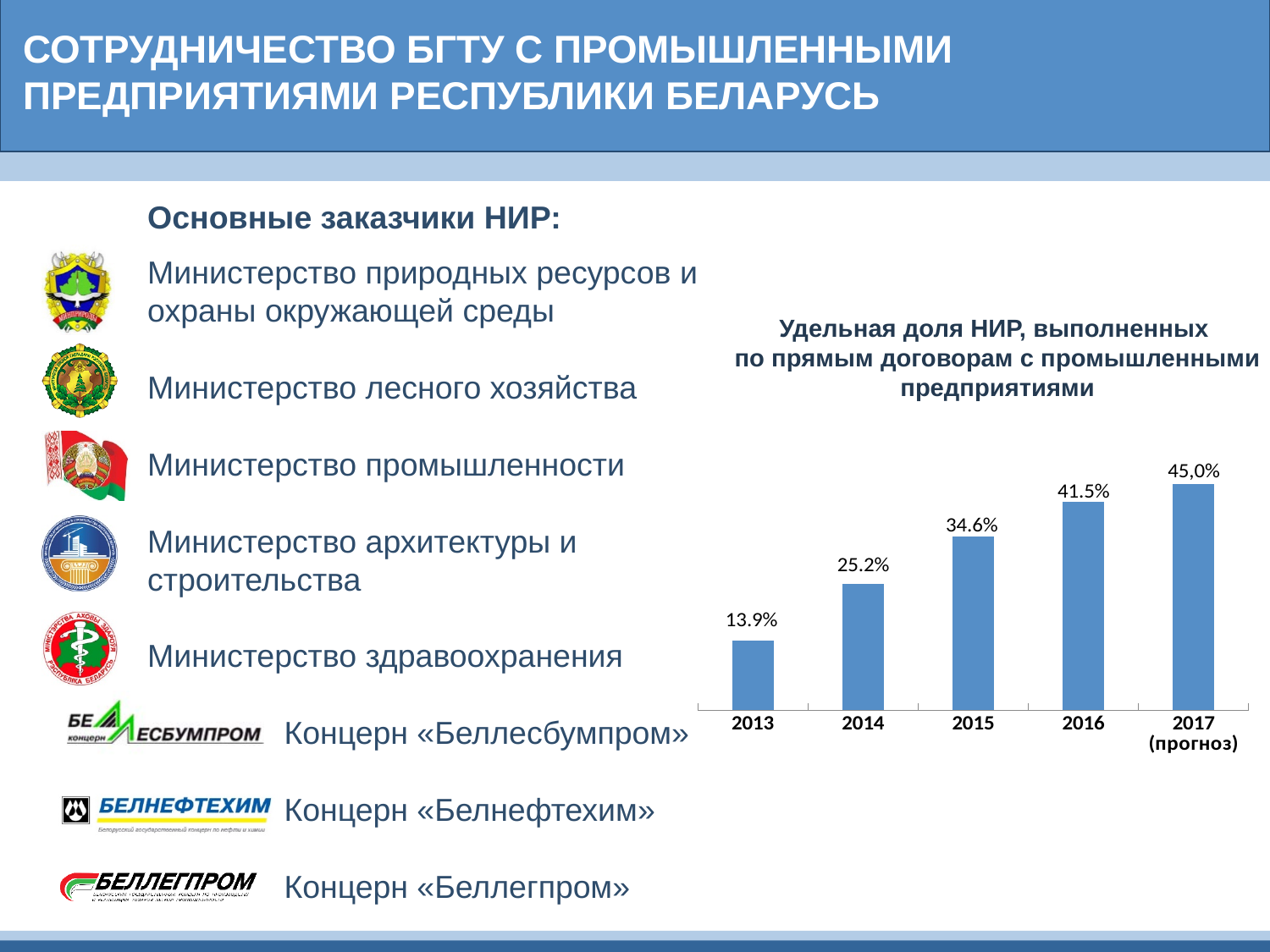
What is the value for 2016? 41.5% What kind of chart is shown? bar chart How many years are shown on the x axis? 5 What is the difference between the values for 2014 and 2013? 11.3% Which year has the lowest value? 2013 What is the value for 2015? 34.6% Which year has the highest value? 2017 (прогноз) Do the values rise or fall from 2013 to 2017? rise What is the value for 2013? 13.9% Which is larger, the value for 2014 or the value for 2015? 2015 What is the difference between the values for 2016 and 2015? 6.9% What is the value shown for 2017 (прогноз)? 45,0%